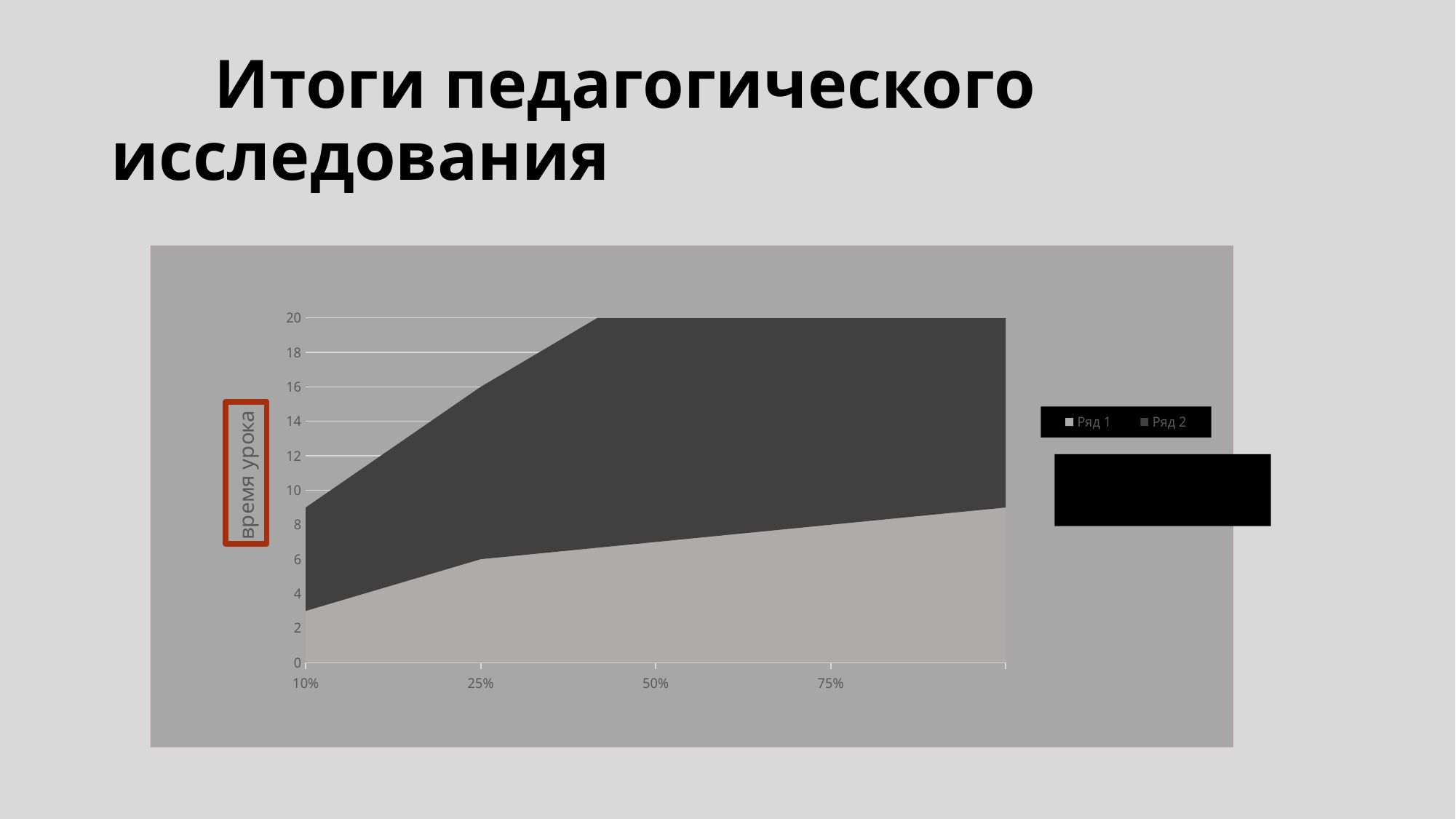
Is the top of the Ряд 2 area at 25% greater or less than 12? greater What kind of chart is shown on the slide? area chart Is the value for Ряд 1 at 10% greater or less than 4? less What is the highest value shown on the vertical axis? 20 What are the names of the series in the legend? Ряд 1, Ряд 2 Do the values for Ряд 1 rise or fall along the horizontal axis? rise How many category labels are shown on the horizontal axis? 4 What is the title of the vertical axis? время урока Is the top of the Ряд 2 area at 10% greater or less than 10? less How many series does the legend list? 2